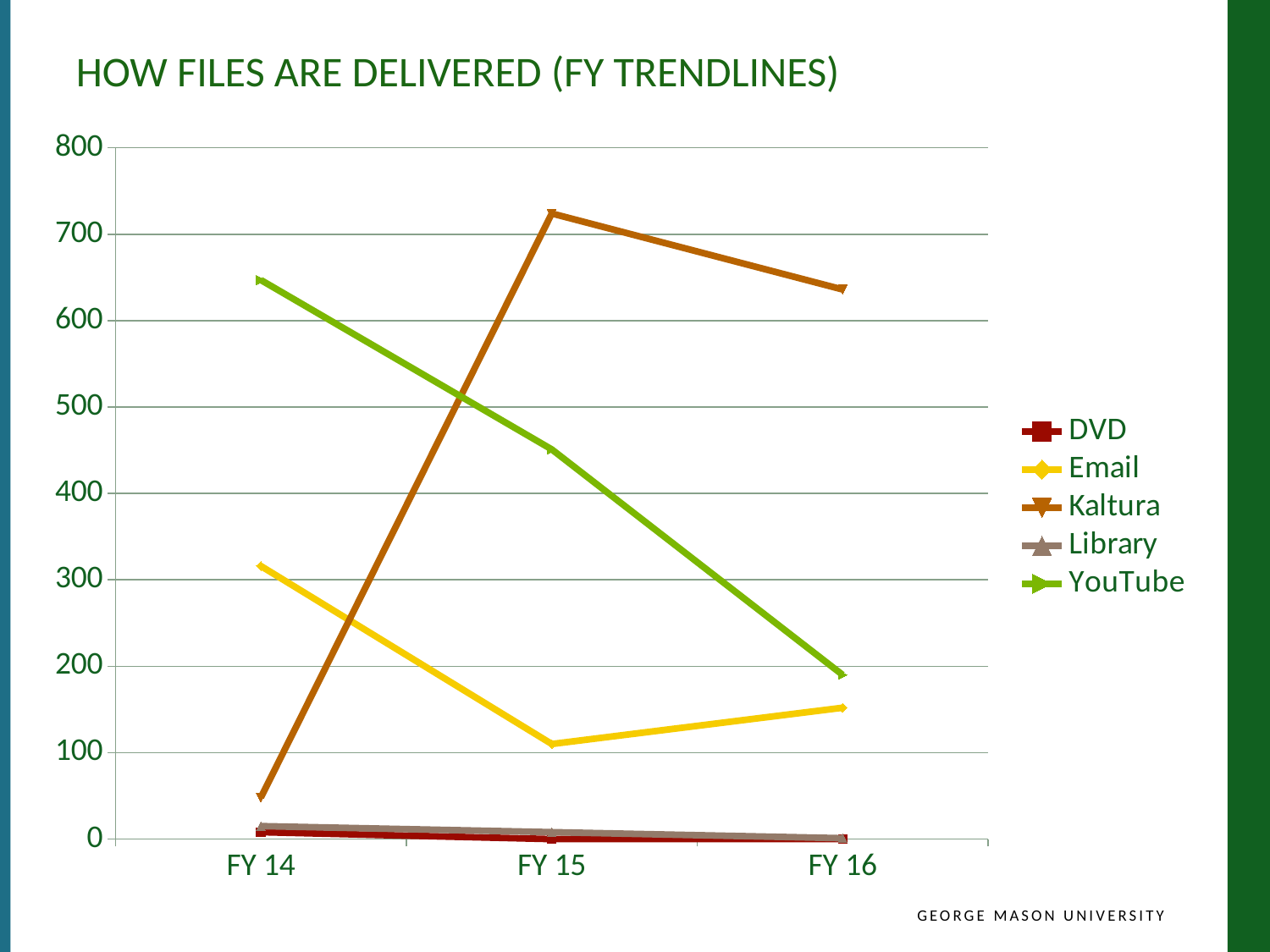
Is the value for Email in FY 15 greater or less than 200? less How many fiscal years are plotted along the x axis? 3 Which series has the highest value in FY 14? YouTube Does the Kaltura line rise or fall from FY 14 to FY 15? rise How many series does the legend list? 5 Does the YouTube line rise or fall from FY 14 to FY 16? fall Is the value for Kaltura in FY 15 greater or less than 700? greater Which series has the highest value in FY 15? Kaltura What kind of chart is shown on the slide? line chart What is the title of the chart? HOW FILES ARE DELIVERED (FY TRENDLINES) Is the value for YouTube in FY 14 greater or less than 600? greater In FY 16, which is larger: Kaltura or YouTube? Kaltura